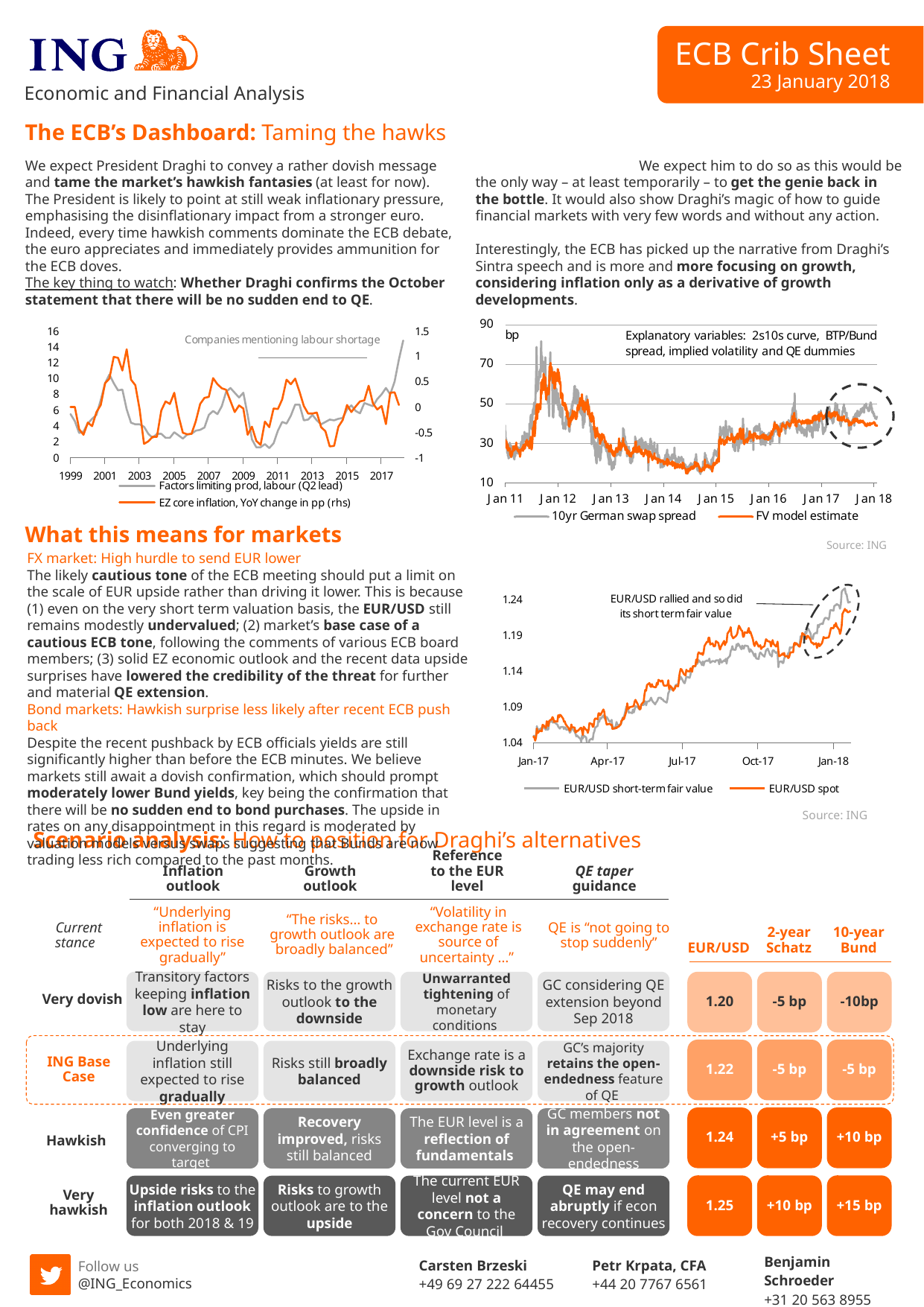
What kind of chart is the top-right chart with the 10yr German swap spread? Line chart What kind of chart is the top-left chart showing companies mentioning labour shortage? Line chart In the top-right chart, what unit is shown on the y axis? bp In the top-left chart, which series is plotted on the right-hand axis according to the legend? EZ core inflation, YoY change in pp (rhs) In the middle-right EUR/USD chart, is the EUR/USD spot at Jan-17 greater or less than 1.09? less In the top-right chart, is the 10yr German swap spread at Jan 14 greater or less than 50? less How many series does the legend of the top-right chart (10yr German swap spread) list? 2 In the top-right chart, is the FV model estimate at Jan 18 greater or less than 30? greater How many series does the legend of the top-left chart (companies mentioning labour shortage) list? 2 In the middle-right EUR/USD chart, does the EUR/USD spot rise or fall from Jan-17 to Jan-18? rise How many series does the legend of the middle-right EUR/USD chart list? 2